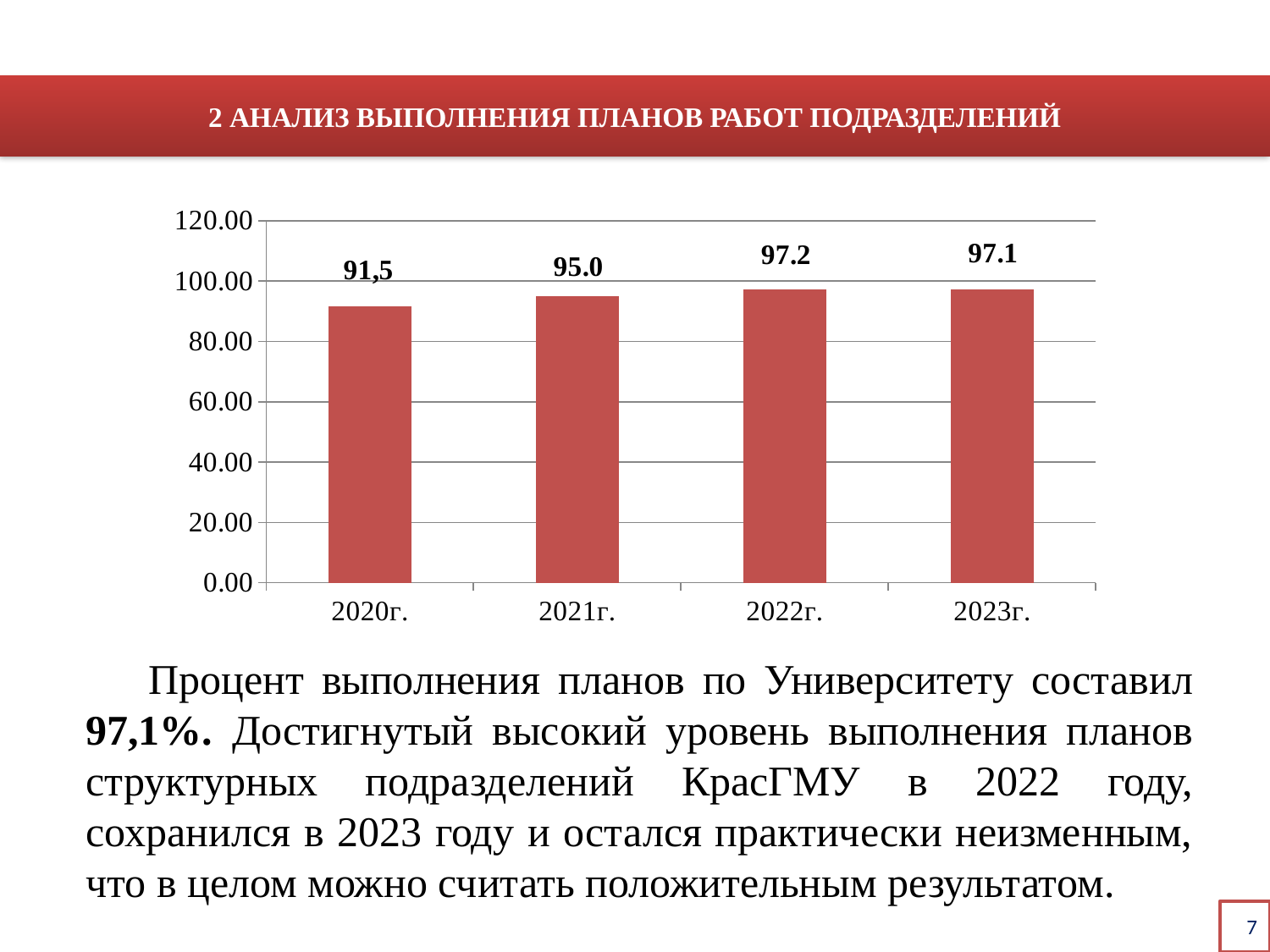
What is the value for 2020г.? 91,5 Which year has the highest value? 2022г. What is the difference between the values for 2021г. and 2020г.? 3.5 What is the value for 2023г.? 97.1 What is the difference between the values for 2022г. and 2021г.? 2.2 What is the value for 2022г.? 97.2 Is the value for 2020г. greater or less than 100.00? less What is the value for 2021г.? 95.0 How many years are shown on the x axis? 4 Which year has the lowest value? 2020г. Which is larger, the value for 2020г. or the value for 2021г.? 2021г. What kind of chart is shown on the slide? bar chart